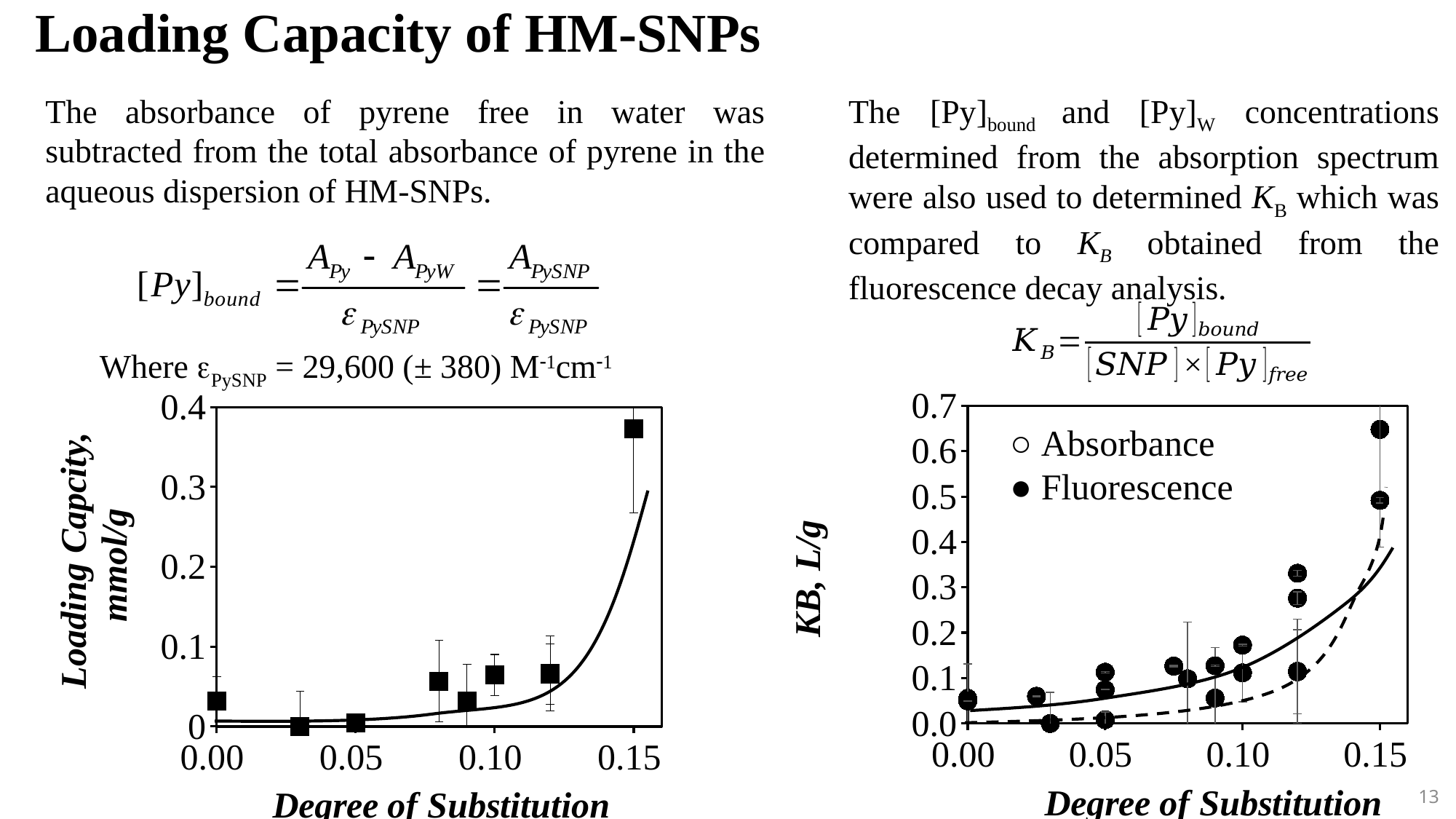
In the right chart (KB, L/g), is the highest KB value at a degree of substitution of 0.15 greater or less than 0.6? greater In the right chart (KB, L/g), do the KB values generally rise or fall as the degree of substitution increases? rise How many series does the legend of the right chart (KB, L/g) list? 2 In the left chart (Loading Capacity, mmol/g), is the loading capacity at a degree of substitution of 0.15 greater or less than 0.3? greater In the left chart (Loading Capacity, mmol/g), which has the larger loading capacity: the point at a degree of substitution of 0.15 or the point at 0.05? 0.15 In the left chart (Loading Capacity, mmol/g), at which degree of substitution is the loading capacity highest? 0.15 What are the two series named in the legend of the right chart (KB, L/g)? Absorbance and Fluorescence What kind of chart is the left chart (Loading Capacity vs Degree of Substitution)? scatter chart In the left chart (Loading Capacity, mmol/g), is the loading capacity at a degree of substitution of 0.00 greater or less than 0.1? less What kind of chart is the right chart (KB vs Degree of Substitution)? scatter chart What is the y-axis label of the left chart? Loading Capcity, mmol/g